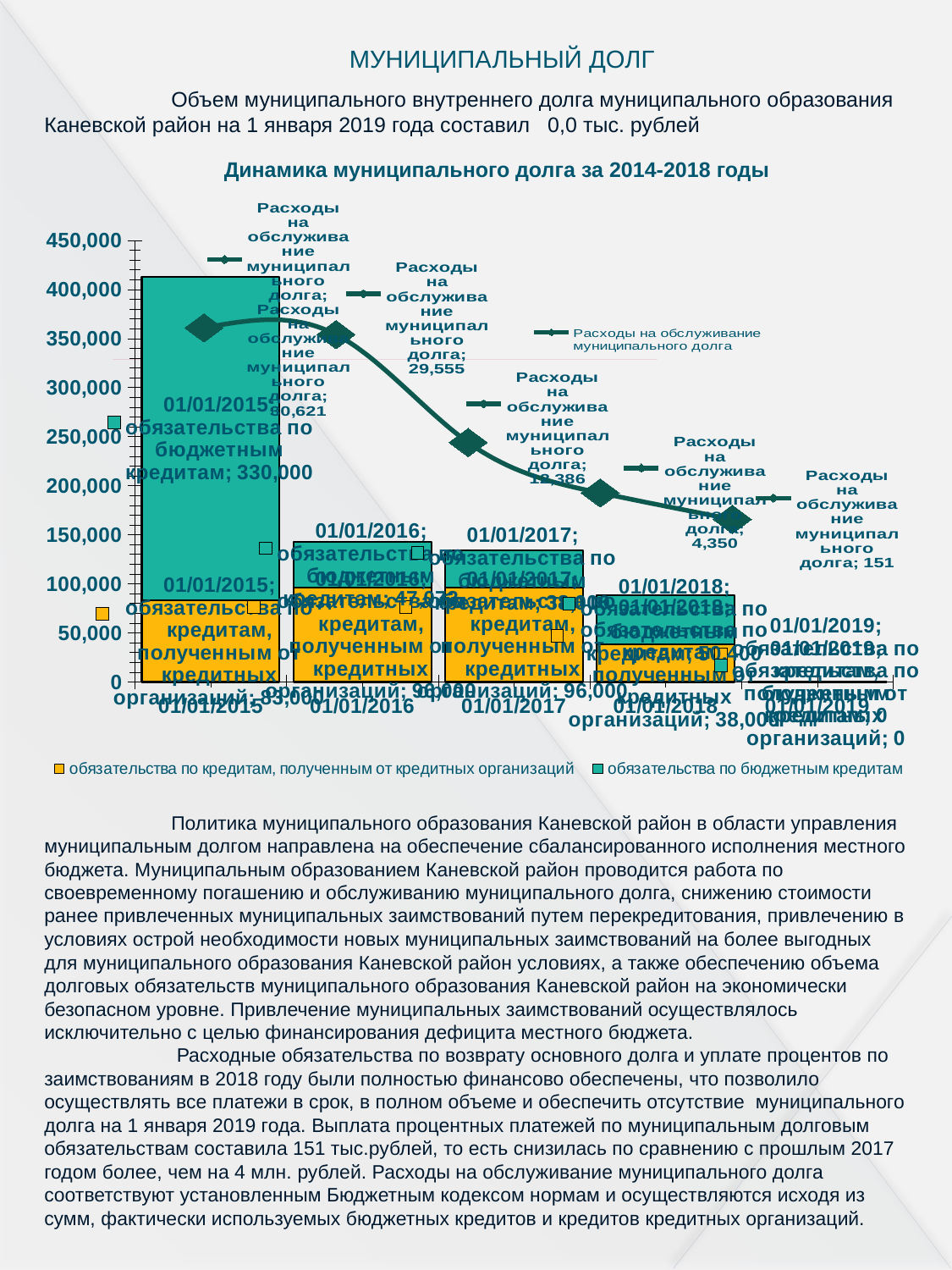
What is the value of 'Расходы на обслуживание муниципального долга' at the first point (01/01/2015)? 30,621 What is the total of the stacked bar for 01/01/2015? 413,000 What kind of chart is used for 'Динамика муниципального долга за 2014-2018 годы'? A bar chart combined with a line What is the difference between 'Расходы на обслуживание муниципального долга' at 01/01/2015 (30,621) and at 01/01/2016 (29,555)? 1,066 Which is larger: 'обязательства по кредитам, полученным от кредитных организаций' on 01/01/2015 or on 01/01/2016? 01/01/2016 On which date is 'обязательства по бюджетным кредитам' highest? 01/01/2015 What is the value of 'обязательства по кредитам, полученным от кредитных организаций' on 01/01/2016? 96,000 What is the value of 'Расходы на обслуживание муниципального долга' at the last point (01/01/2019)? 151 What is the value of 'обязательства по бюджетным кредитам' on 01/01/2015? 330,000 Does 'Расходы на обслуживание муниципального долга' rise or fall from 01/01/2015 to 01/01/2019? Fall How many series does the legend at the bottom of the chart list? 2 What is the value of 'обязательства по кредитам, полученным от кредитных организаций' on 01/01/2015? 83,000